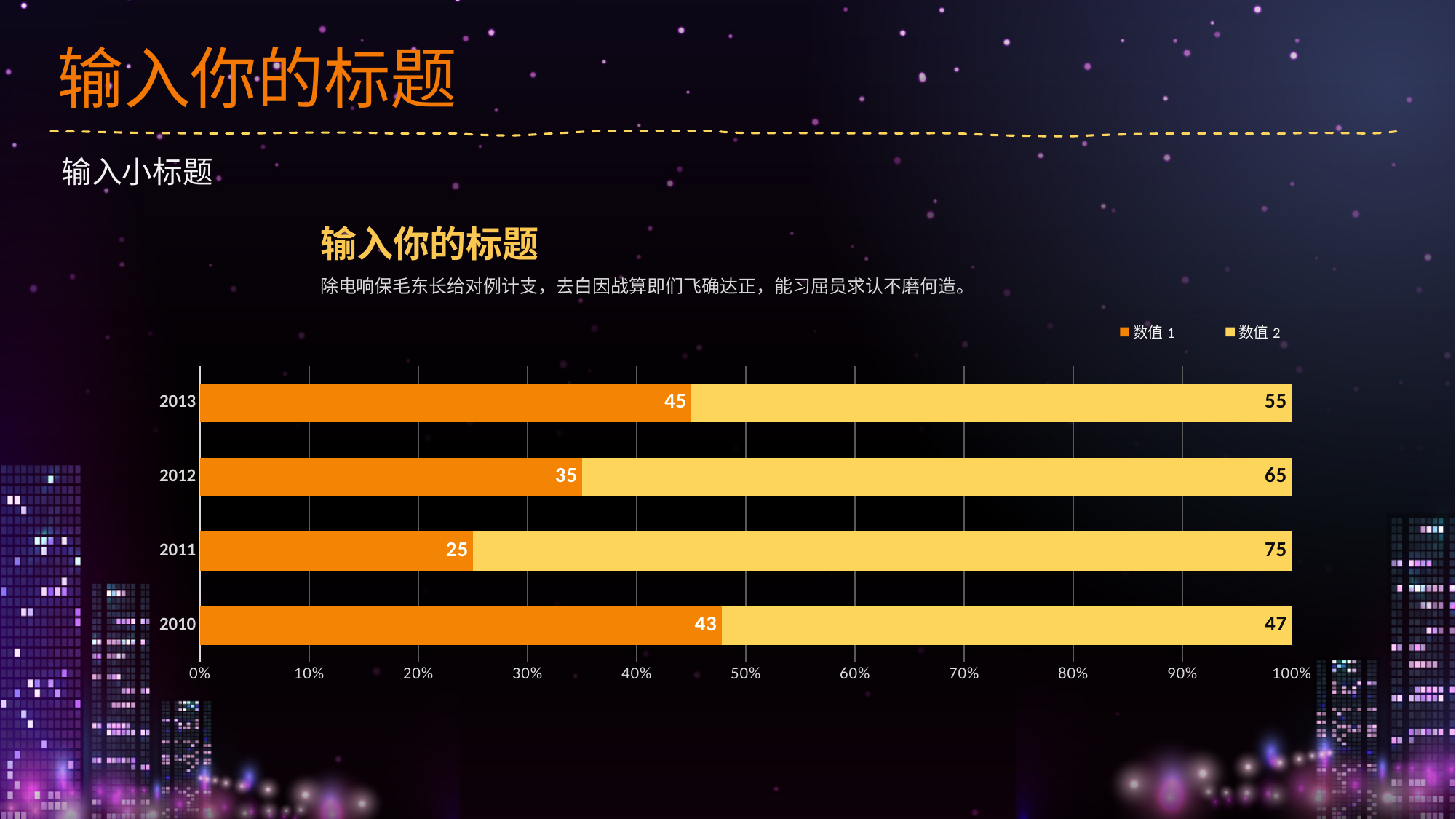
What is the value of 数值 1 for 2012? 35 What is the value of 数值 2 for 2011? 75 Which is larger for 2010, 数值 1 or 数值 2? 数值 2 What is the total of the stacked bar for 2013? 100 What is the difference between 数值 2 and 数值 1 for 2012? 30 What is the value of 数值 2 for 2010? 47 How many series does the legend list? 2 Which year has the highest value for 数值 2? 2011 How many years are shown on the chart? 4 What is the value of 数值 1 for 2013? 45 What kind of chart is shown on the slide? Stacked bar chart Which year has the lowest value for 数值 1? 2011